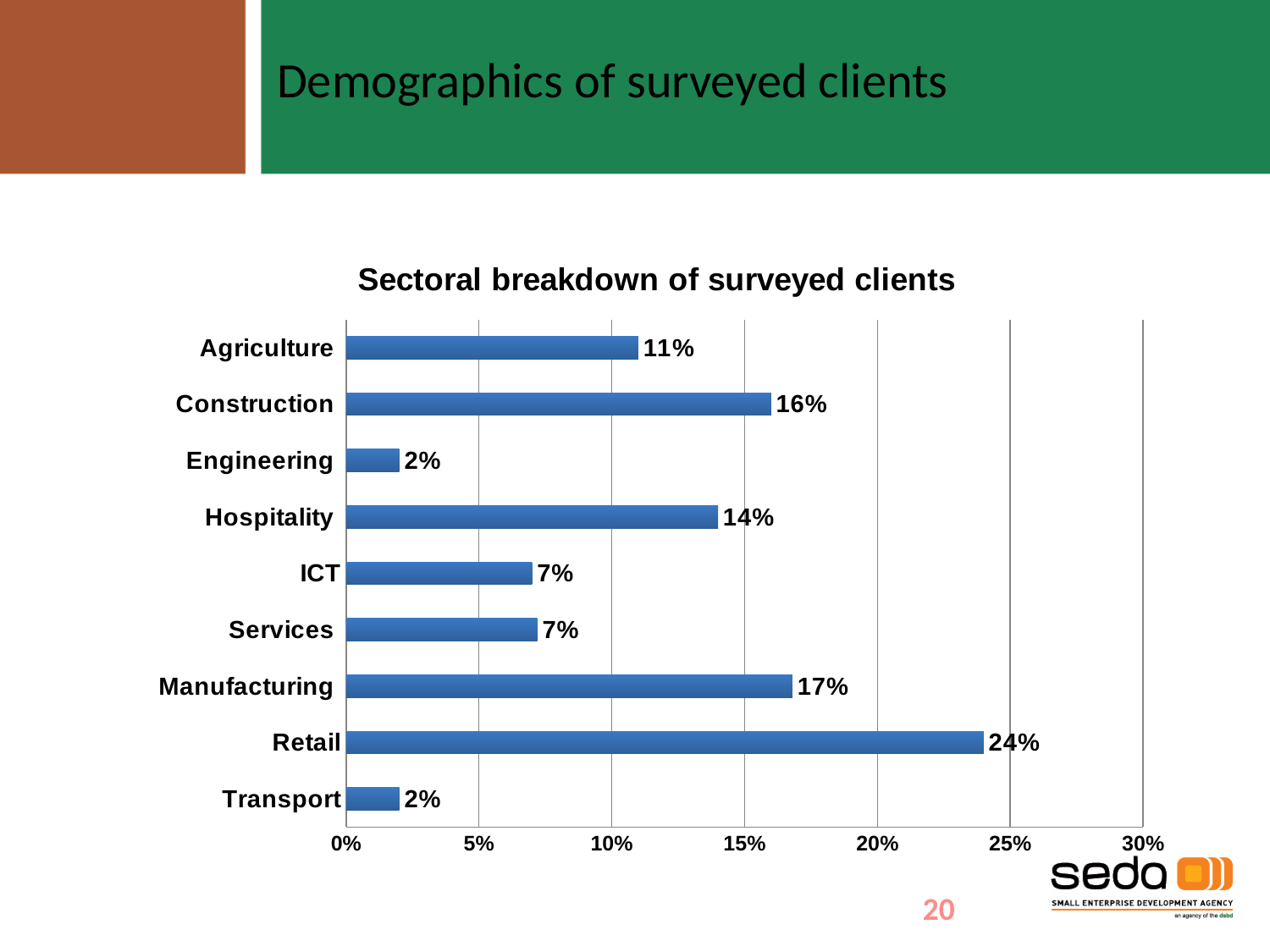
What is the difference between the Construction and Agriculture values? 5% What is the value shown for Hospitality? 14% Which sectors share the lowest value on the chart? Engineering and Transport How many sectors are shown on the chart? 9 What is the difference between the Retail and Manufacturing values? 7% Which sector has the highest share of surveyed clients? Retail What percentage of surveyed clients are in Construction? 16% Is the value for Agriculture greater or less than 10%? greater What percentage of surveyed clients are in the Retail sector? 24% What is the title of the chart? Sectoral breakdown of surveyed clients What kind of chart is shown on the slide? Bar chart Which is larger, the value for Manufacturing or the value for Hospitality? Manufacturing